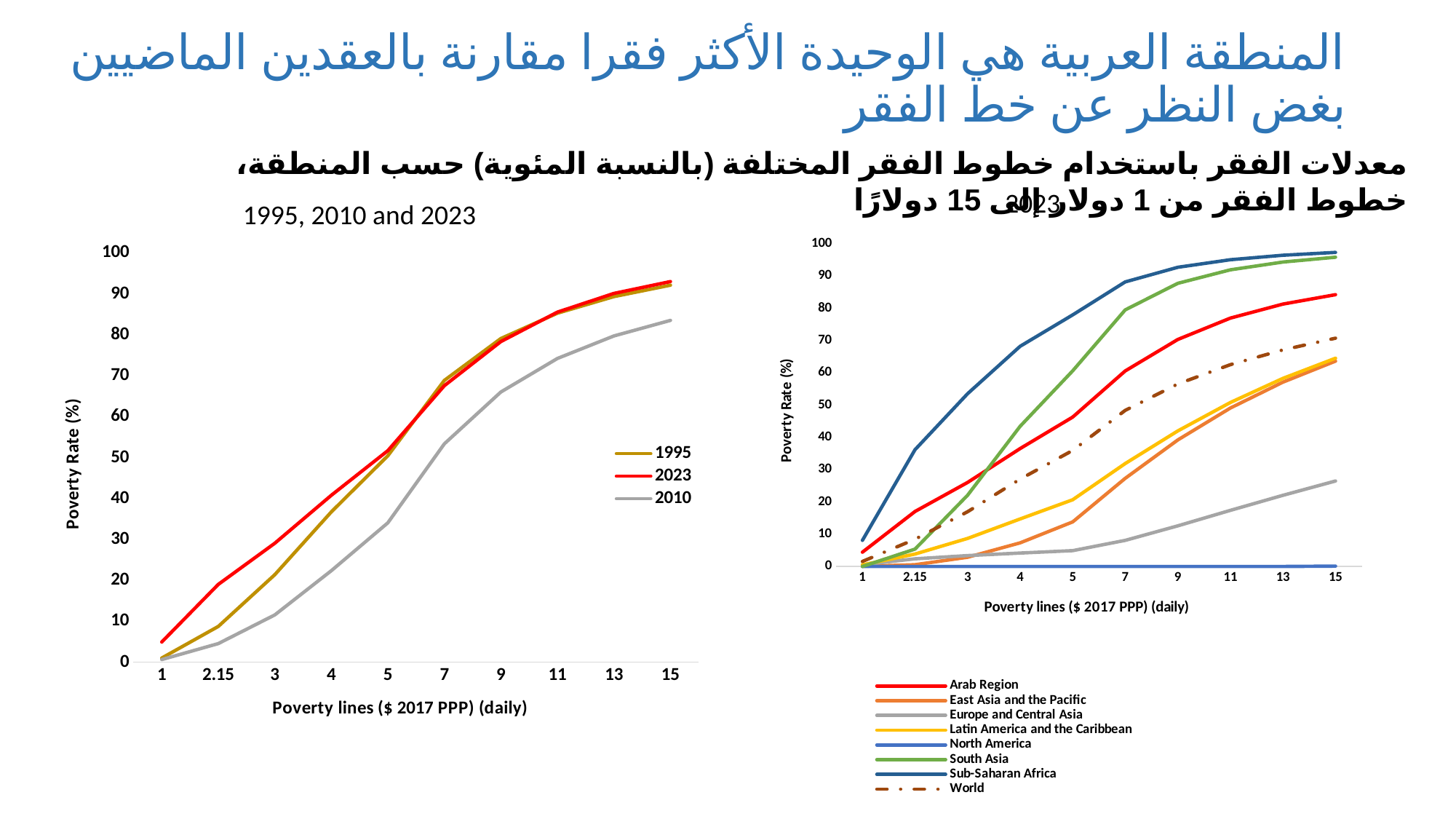
In the right chart ('2023'), is the Sub-Saharan Africa value at the $4 poverty line greater or less than 60? greater In the right chart ('2023'), which series has the lowest value at the $15 poverty line? North America What type of chart is the left chart titled '1995, 2010 and 2023'? line chart In the right chart ('2023'), is the Europe and Central Asia value at the $15 poverty line greater or less than 30? less How many series does the legend of the right chart ('2023') list? 8 How many poverty-line points are plotted along the x axis of the right chart ('2023')? 10 In the right chart ('2023'), which is larger at the $15 poverty line: Arab Region or Sub-Saharan Africa? Sub-Saharan Africa In the left chart ('1995, 2010 and 2023'), is the 2023 value at the $3 poverty line greater or less than 20? greater In the left chart ('1995, 2010 and 2023'), which series has the lowest value at the $5 poverty line? 2010 In the right chart ('2023'), does the Arab Region line rise or fall as the poverty line increases from $1 to $15? rise How many series does the legend of the left chart ('1995, 2010 and 2023') list? 3